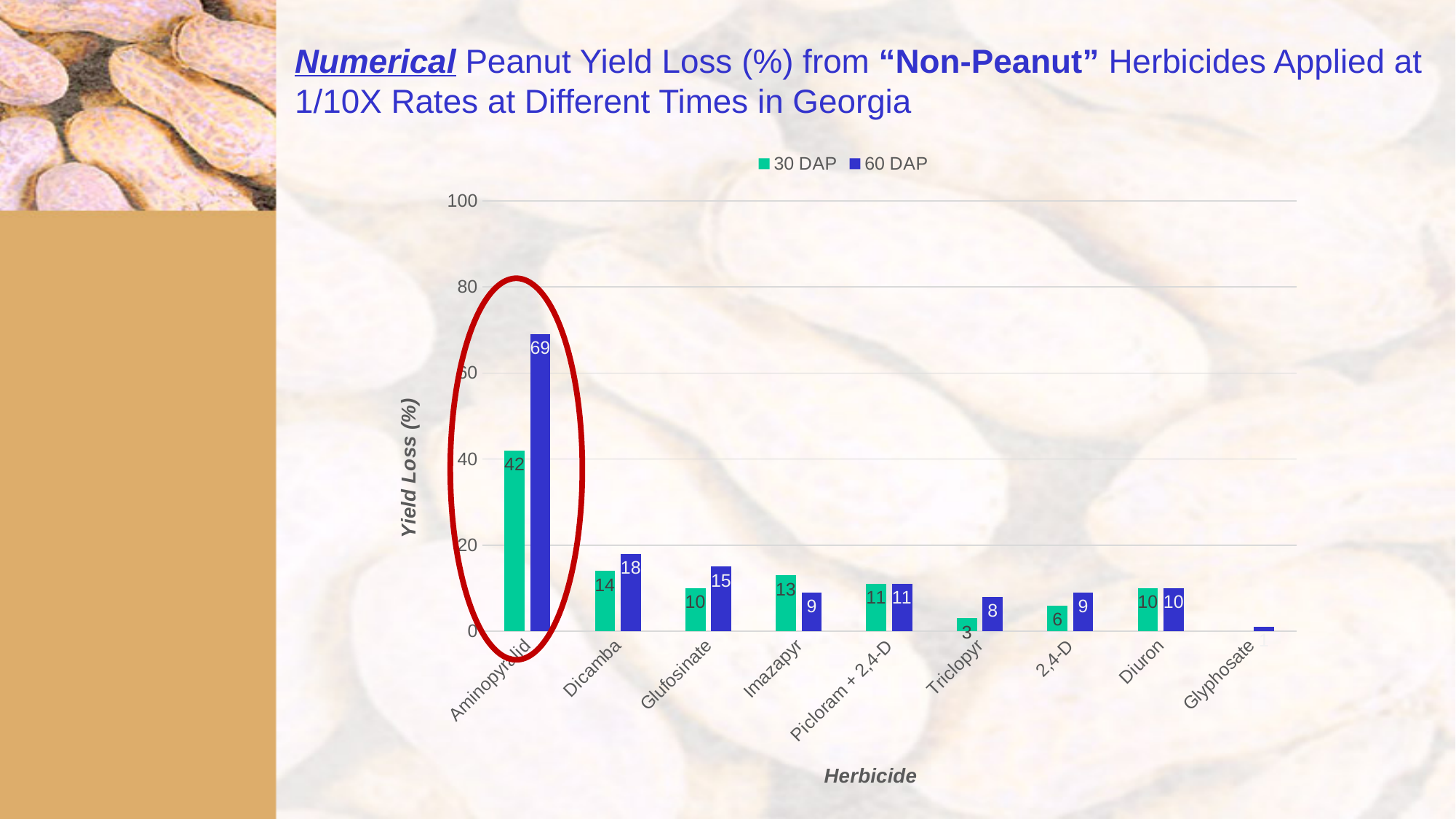
Which herbicide has the highest yield loss at 60 DAP? Aminopyralid What is the yield loss for Aminopyralid at 60 DAP? 69 What kind of chart is shown on the slide? Bar chart How many series does the legend list? 2 What is the yield loss for Dicamba at 60 DAP? 18 What is the yield loss for Triclopyr at 30 DAP? 3 What is the yield loss for Glufosinate at 60 DAP? 15 How many herbicides are shown on the x axis? 9 What is the difference between the 60 DAP and 30 DAP yield loss for Aminopyralid? 27 What is the yield loss for Aminopyralid at 30 DAP? 42 For Imazapyr, which is larger: the 30 DAP or the 60 DAP yield loss? 30 DAP What is the difference between the 60 DAP and 30 DAP yield loss for Dicamba? 4